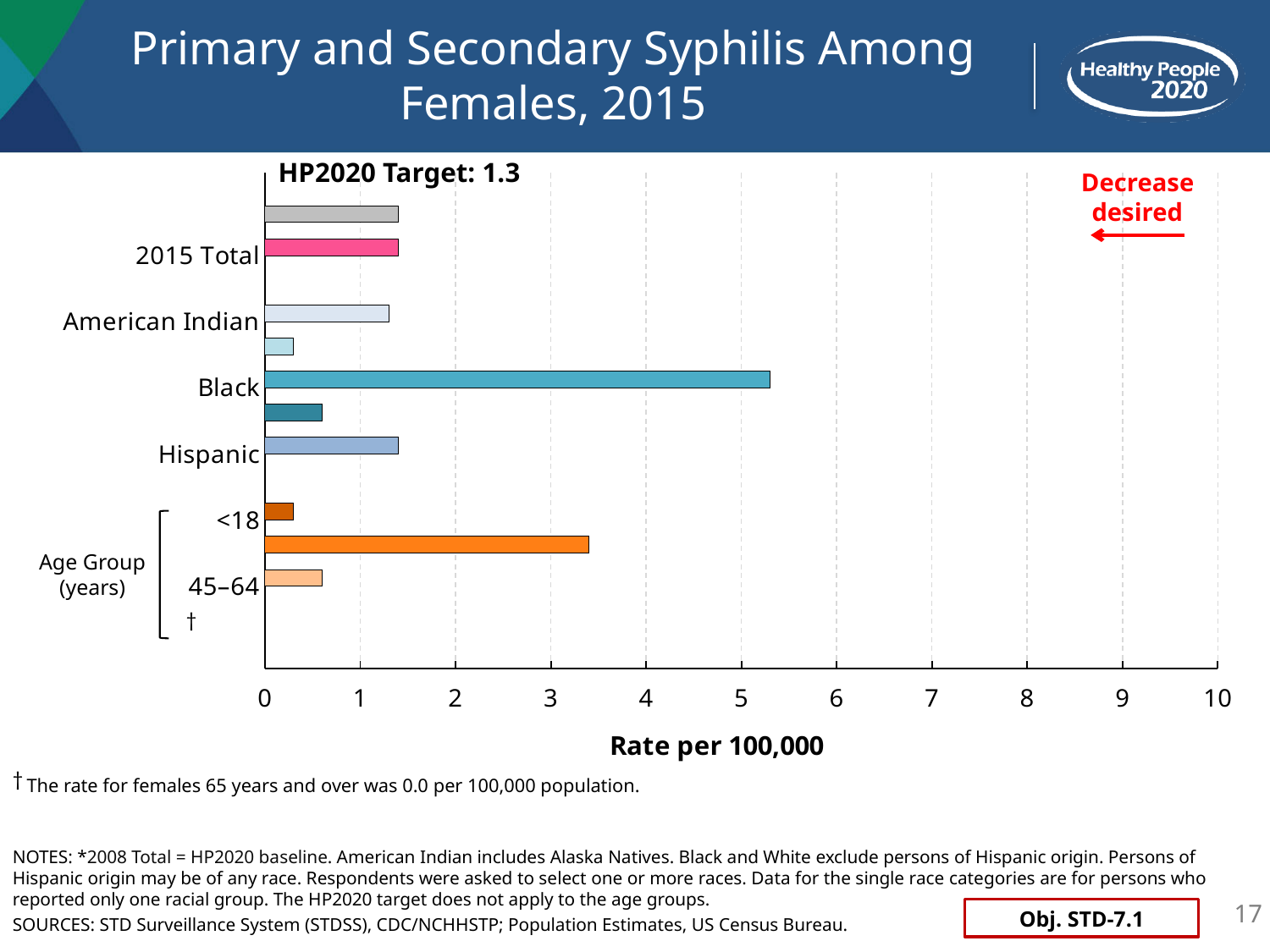
Is the rate for Hispanic females greater or less than 1 per 100,000? greater What is the title of the x axis? Rate per 100,000 Which labeled group has the highest rate of primary and secondary syphilis among females in 2015? Black Which is larger, the rate for females aged <18 or the rate for females aged 45–64? 45–64 Is the rate for females aged 45–64 greater or less than 1 per 100,000? less What is the HP2020 target shown on the chart? 1.3 Is the 2015 Total rate greater or less than 2 per 100,000? less What kind of chart is shown on the slide? bar chart Which is larger, the rate for Black females or the rate for Hispanic females? Black